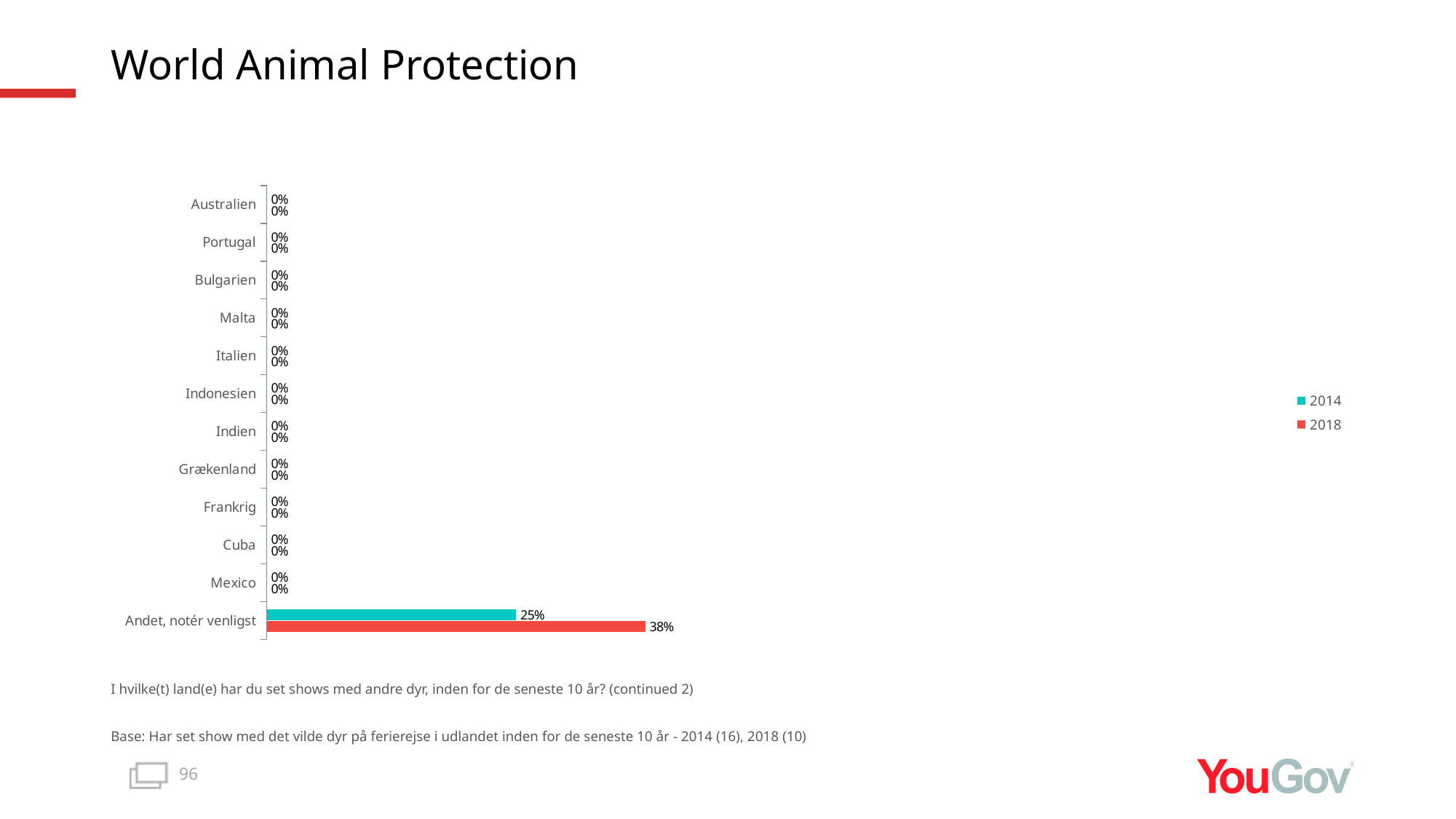
Which category has the highest 2018 value? Andet, notér venligst What is the difference between the 2018 and 2014 values for "Andet, notér venligst"? 13% What is the 2014 value for Italien? 0% Which series is shown in red in the legend? 2018 For "Andet, notér venligst", which year has the larger value, 2014 or 2018? 2018 What is the 2014 value for "Andet, notér venligst"? 25% How many categories are shown on the chart? 12 What is the 2018 value for "Andet, notér venligst"? 38% What is the 2018 value for Mexico? 0% What is the title of the slide? World Animal Protection What kind of chart is shown on the slide? Bar chart How many series does the legend list? 2